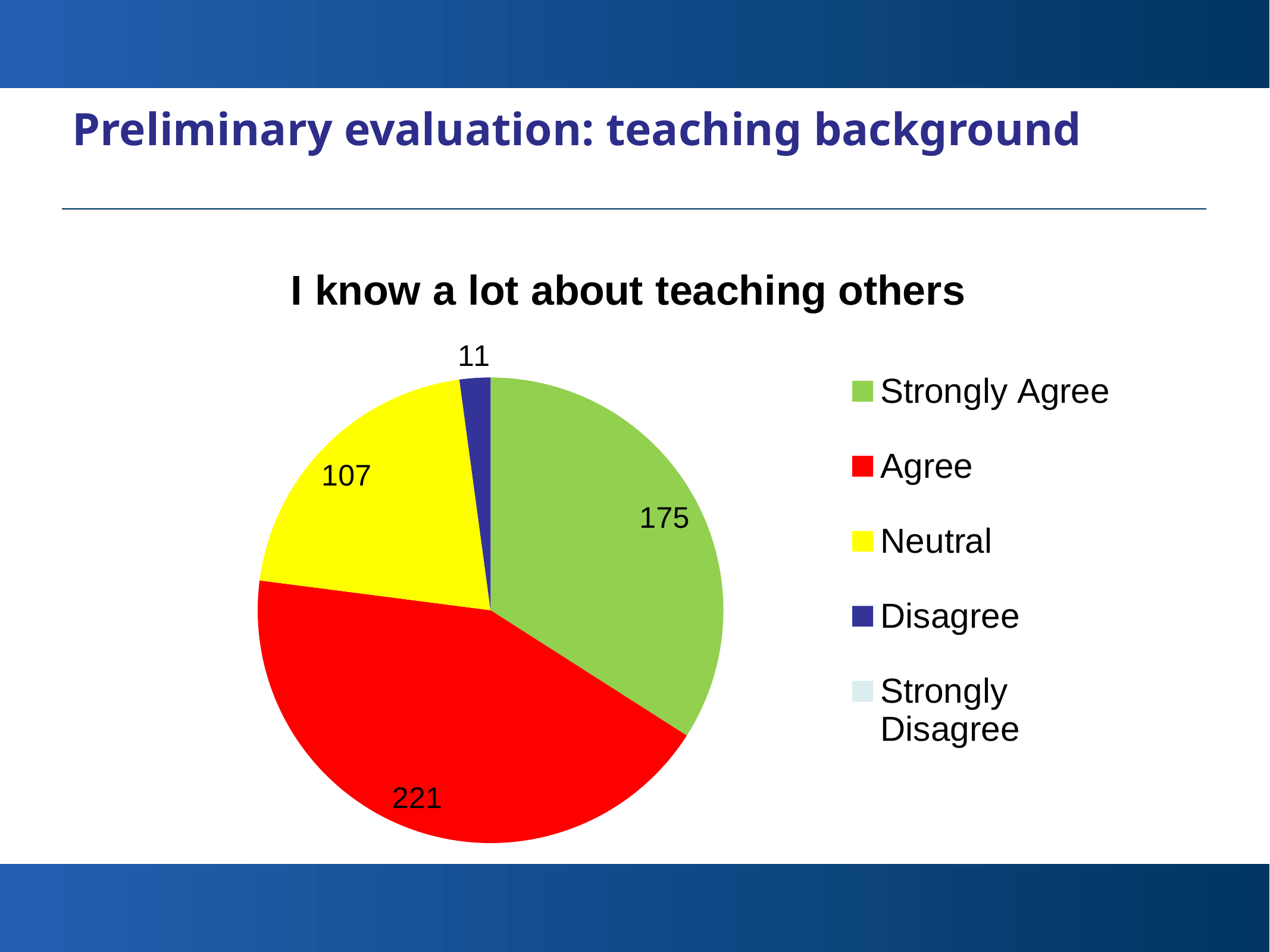
What type of chart is shown on the slide? pie chart How many entries does the legend list? 5 What is the value for Strongly Agree? 175 What is the value for Neutral? 107 Which category has the largest slice? Agree What is the value for Agree? 221 What is the difference between the values for Agree and Strongly Agree? 46 What is the title of the chart? I know a lot about teaching others Which labelled category has the smallest slice? Disagree What is the value for Disagree? 11 Which is larger, the value for Neutral or the value for Disagree? Neutral What is the difference between the values for Strongly Agree and Neutral? 68